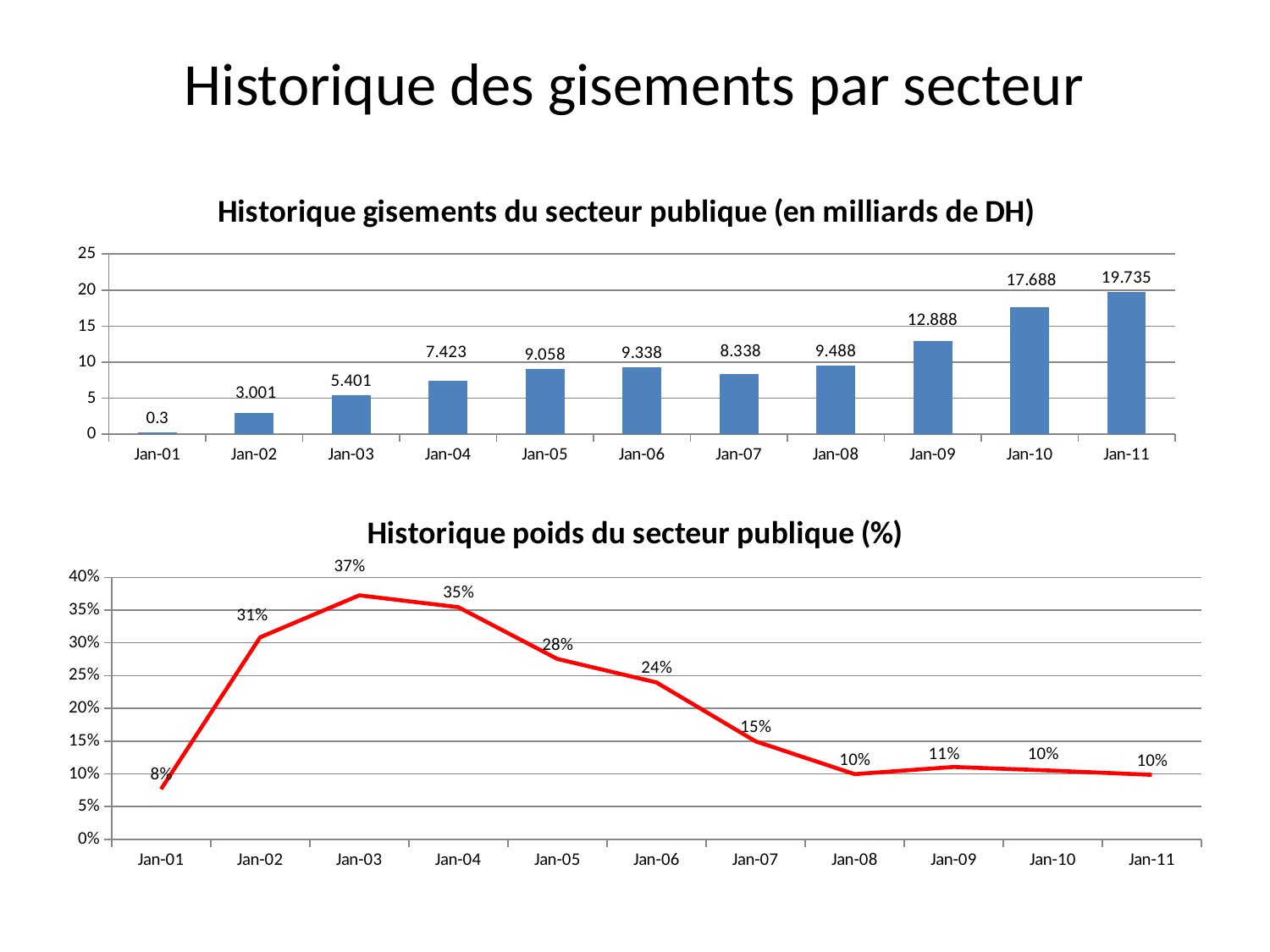
In the chart 'Historique gisements du secteur publique (en milliards de DH)', which year has the highest value? Jan-11 In the chart 'Historique poids du secteur publique (%)', what is the value for Jan-05? 28% In the chart 'Historique gisements du secteur publique (en milliards de DH)', which is larger, the value for Jan-06 or the value for Jan-07? Jan-06 In the chart 'Historique gisements du secteur publique (en milliards de DH)', which year has the lowest value? Jan-01 How many years are shown on the x axis of the chart 'Historique gisements du secteur publique (en milliards de DH)'? 11 In the chart 'Historique poids du secteur publique (%)', what is the difference between the values for Jan-03 and Jan-11? 27% In the chart 'Historique gisements du secteur publique (en milliards de DH)', what is the difference between the values for Jan-11 and Jan-10? 2.047 In the chart 'Historique gisements du secteur publique (en milliards de DH)', what is the value for Jan-09? 12.888 What kind of chart is 'Historique gisements du secteur publique (en milliards de DH)'? bar chart In the chart 'Historique poids du secteur publique (%)', which year has the highest value? Jan-03 What kind of chart is 'Historique poids du secteur publique (%)'? line chart In the chart 'Historique poids du secteur publique (%)', do the values rise or fall from Jan-04 to Jan-08? fall